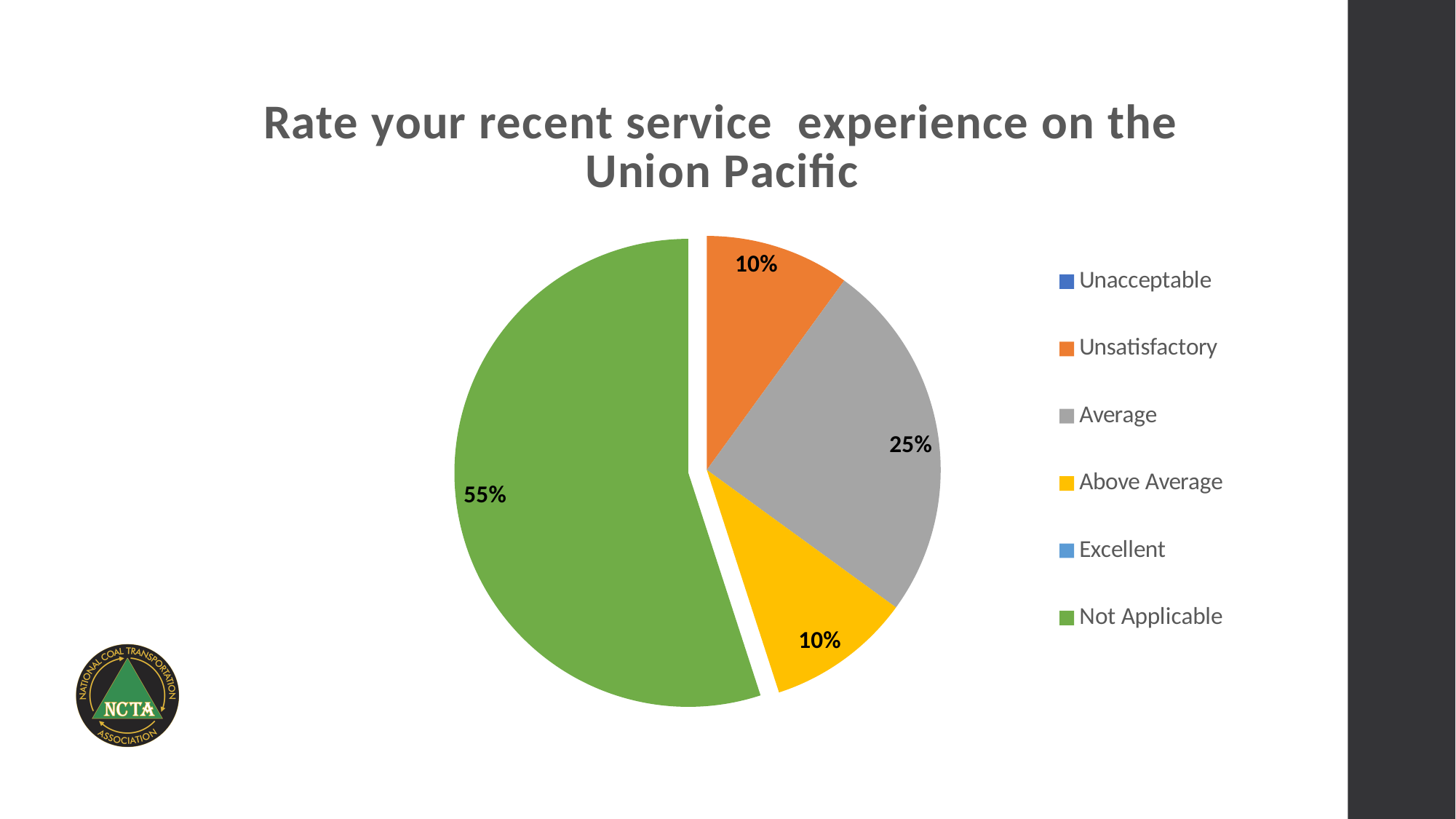
What share of the pie is labelled Unsatisfactory? 10% Which is larger, the Average slice or the Unsatisfactory slice? Average What share of the pie is labelled Not Applicable? 55% What is the difference in percentage points between the Average slice and the Above Average slice? 15% What colour is the Not Applicable slice? green What share of the pie is labelled Average? 25% What kind of chart is shown on the slide? pie chart Which category has the largest slice of the pie? Not Applicable What is the difference in percentage points between the Not Applicable slice and the Average slice? 30% What is the title of the chart? Rate your recent service experience on the Union Pacific How many entries does the legend list? 6